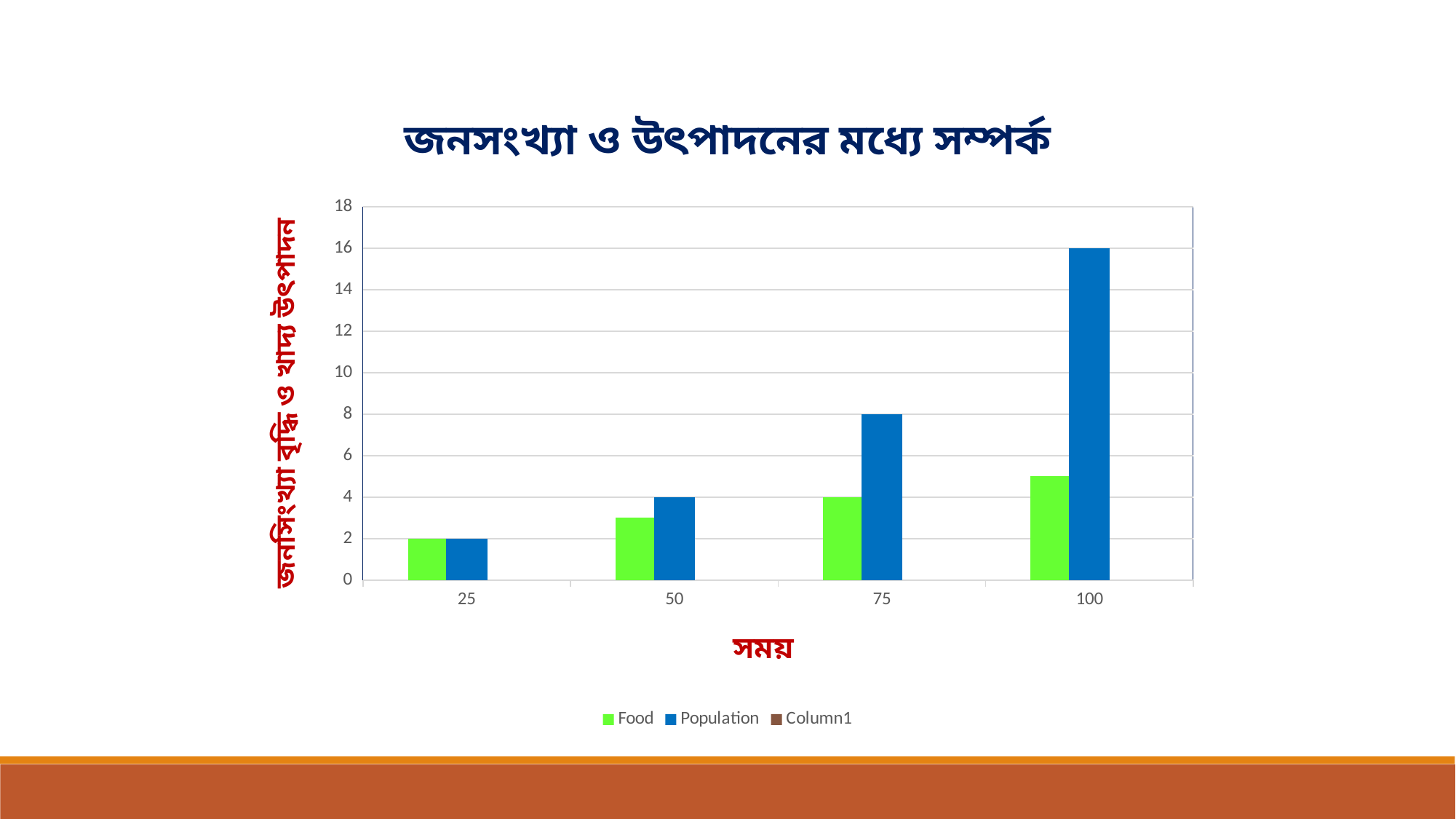
What is the Population value at 100? 16 What is the difference between the Population value at 100 and the Population value at 75? 8 What is the Food value at 75? 4 At which x-axis category is the Population bar highest? 100 What is the Population value at 75? 8 Is the Food value at 50 greater or less than 4? less How many series does the legend list? 3 How many categories are shown on the x axis? 4 What is the Food value at 25? 2 Is the Food value at 100 greater or less than 4? greater At 100, which is larger, Food or Population? Population Do the Population values rise or fall from left to right along the x axis? rise